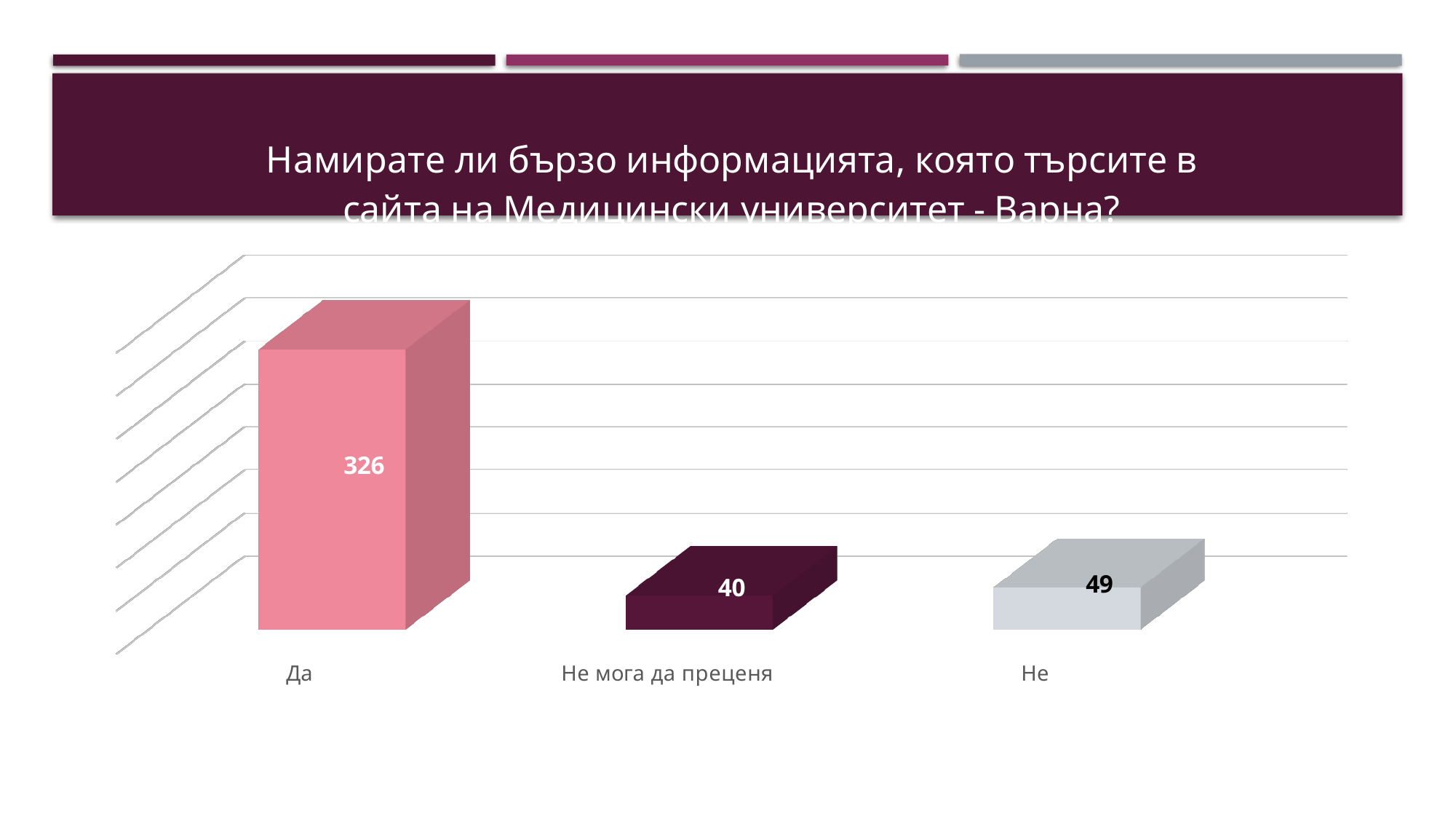
What kind of chart is shown on the slide? bar chart Which category has the highest value? Да What is the value for "Да"? 326 What is the difference between the values for "Да" and "Не"? 277 How many categories are shown on the x axis? 3 Which is larger, the value for "Не" or the value for "Не мога да преценя"? Не What is the difference between the values for "Не" and "Не мога да преценя"? 9 What is the total of the three values shown in the chart? 415 What is the value for "Не мога да преценя"? 40 What is the value for "Не"? 49 Which category has the lowest value? Не мога да преценя What colour is the bar for "Да"? pink